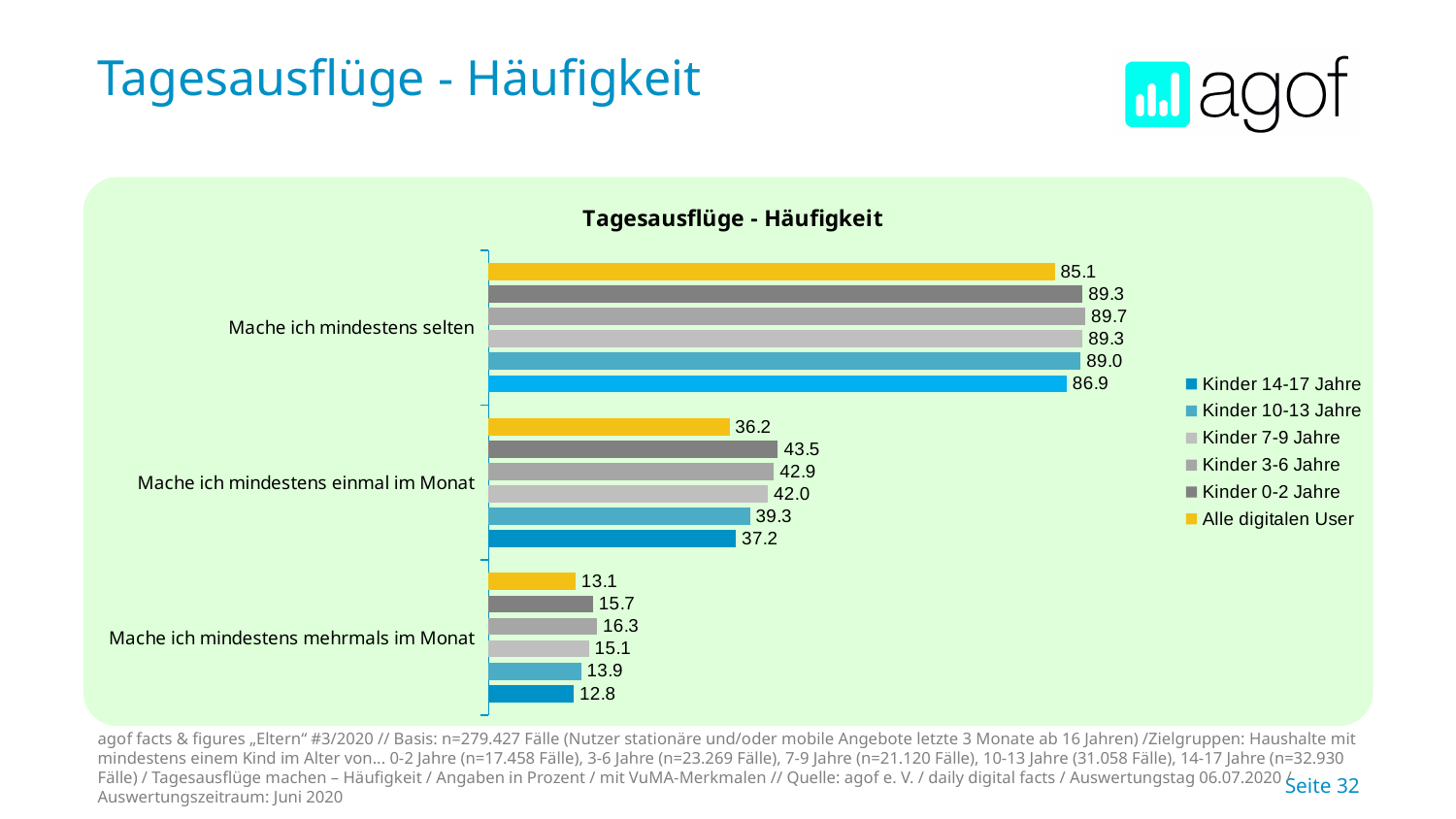
What type of chart is shown on the slide? bar chart What is the value for 'Kinder 14-17 Jahre' in the category 'Mache ich mindestens einmal im Monat'? 37.2 What is the value for 'Alle digitalen User' in the category 'Mache ich mindestens selten'? 85.1 In the category 'Mache ich mindestens selten', which is larger: 'Kinder 10-13 Jahre' or 'Kinder 14-17 Jahre'? Kinder 10-13 Jahre What is the difference between 'Kinder 0-2 Jahre' and 'Alle digitalen User' in the category 'Mache ich mindestens einmal im Monat'? 7.3 What is the value for 'Kinder 3-6 Jahre' in the category 'Mache ich mindestens mehrmals im Monat'? 16.3 Which series has the highest value in the category 'Mache ich mindestens einmal im Monat'? Kinder 0-2 Jahre How many categories are shown on the chart? 3 What is the title of the chart? Tagesausflüge - Häufigkeit Which colour represents 'Alle digitalen User' in the chart? yellow How many series does the legend list? 6 Which series has the lowest value in the category 'Mache ich mindestens mehrmals im Monat'? Kinder 14-17 Jahre